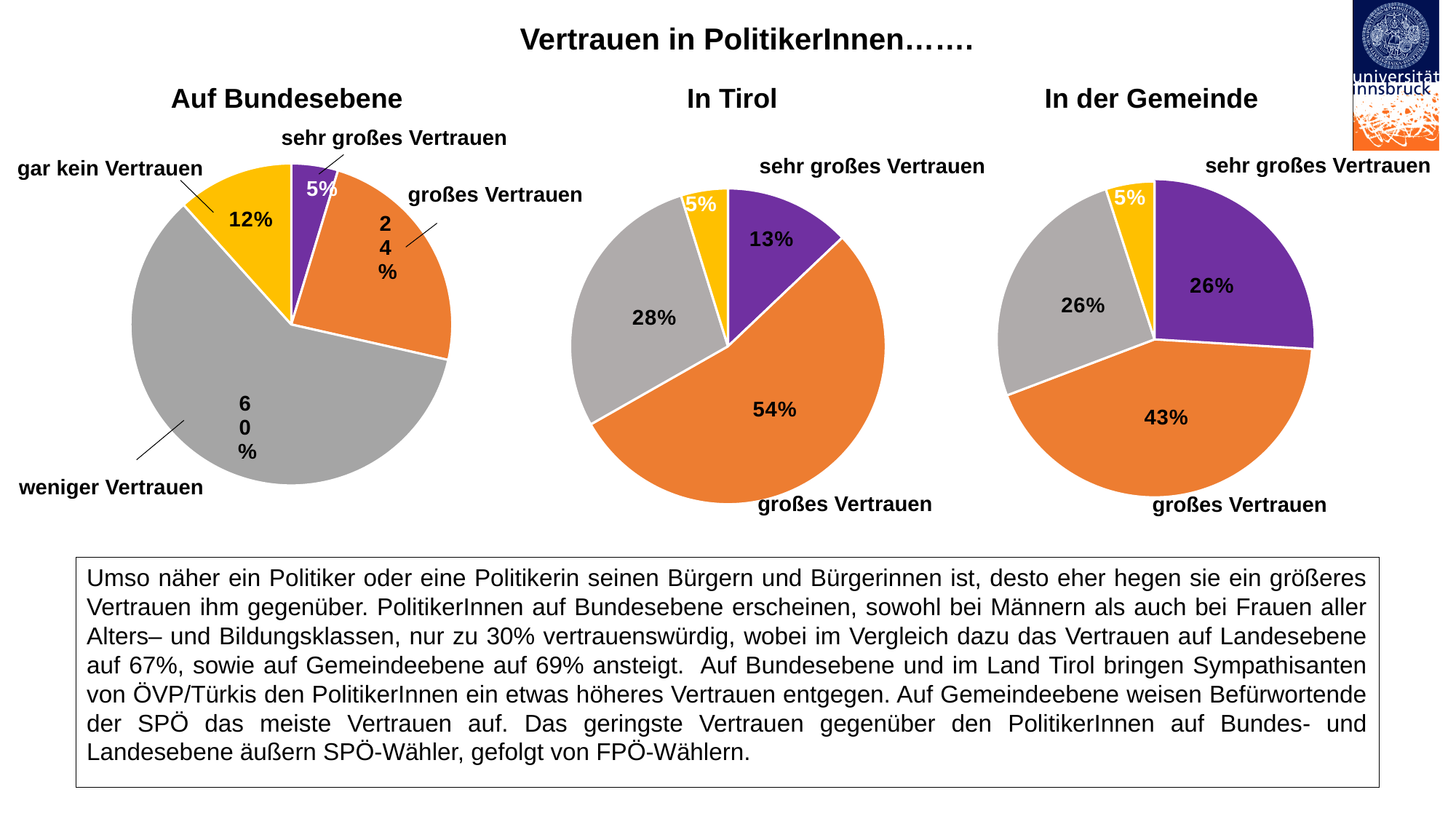
In the 'Auf Bundesebene' chart, which category has the smallest slice? sehr großes Vertrauen In the 'In Tirol' chart, what share is labelled for 'sehr großes Vertrauen'? 13% In the 'Auf Bundesebene' chart, what share is labelled for 'gar kein Vertrauen'? 12% In the 'In Tirol' chart, what share is labelled for 'großes Vertrauen'? 54% In the 'Auf Bundesebene' chart, what share is labelled for 'großes Vertrauen'? 24% What type of chart is used for 'In Tirol'? pie chart In the 'Auf Bundesebene' chart, which category has the largest slice? weniger Vertrauen In the 'In der Gemeinde' chart, what share is labelled for 'sehr großes Vertrauen'? 26% In the 'Auf Bundesebene' chart, what share is labelled for 'weniger Vertrauen'? 60% In the 'In der Gemeinde' chart, what share is labelled for 'großes Vertrauen'? 43% What is the difference between the 'sehr großes Vertrauen' share in the 'In der Gemeinde' chart and in the 'In Tirol' chart? 13% Which is larger: 'großes Vertrauen' in the 'In Tirol' chart or 'großes Vertrauen' in the 'In der Gemeinde' chart? In Tirol